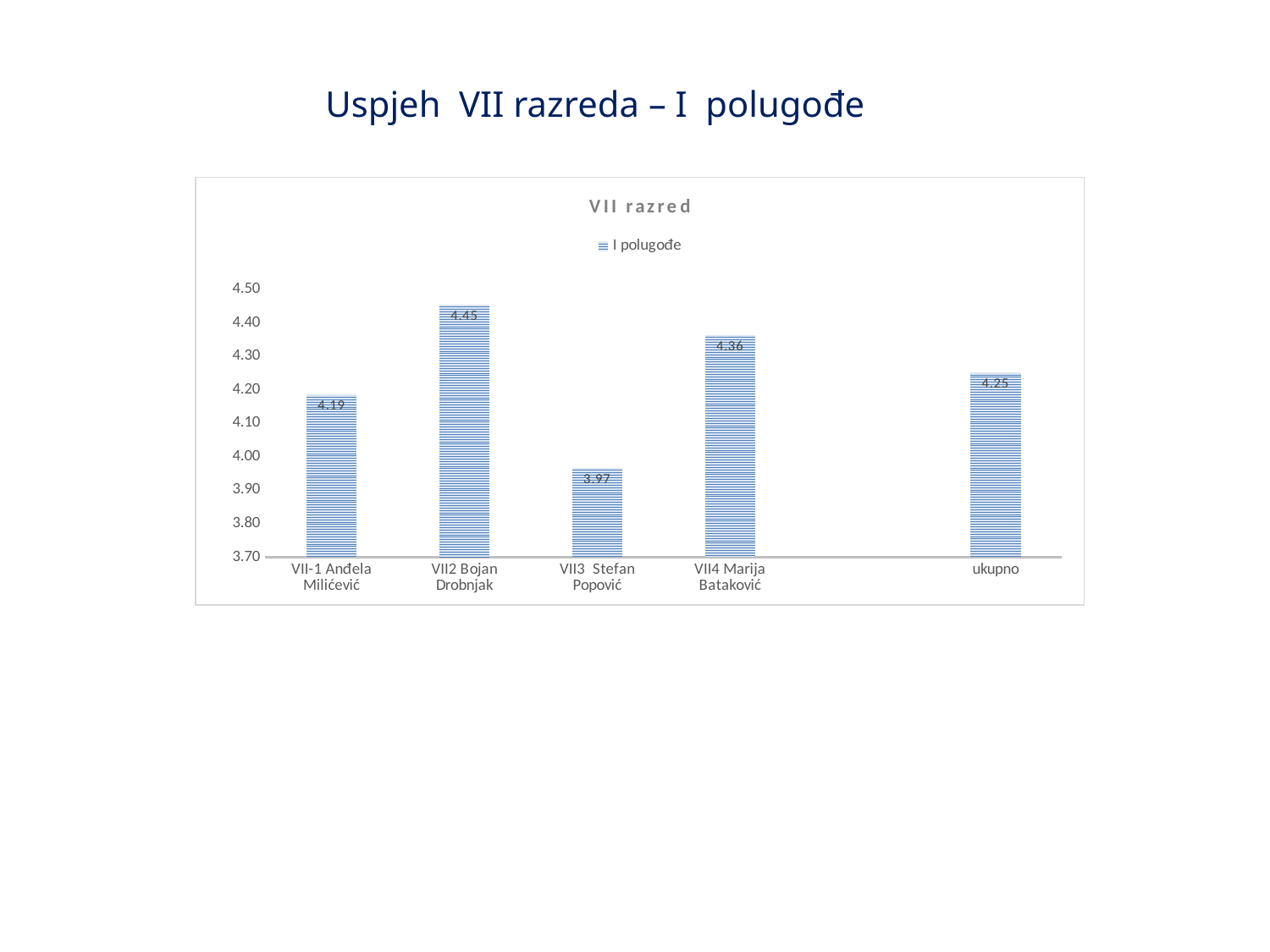
What is the value for VII2 Bojan Drobnjak? 4.45 Which is larger, the value for VII4 Marija Bataković or the value for ukupno? VII4 Marija Bataković Which category has the lowest value? VII3 Stefan Popović Is the value for VII-1 Anđela Milićević greater or less than 4.20? less What is the difference between the values for VII2 Bojan Drobnjak and VII3 Stefan Popović? 0.48 What is the value for VII-1 Anđela Milićević? 4.19 Which category has the highest value? VII2 Bojan Drobnjak How many categories are shown on the x axis? 5 What kind of chart is shown? bar chart How many series does the legend list? 1 What is the value for ukupno? 4.25 What is the value for VII3 Stefan Popović? 3.97